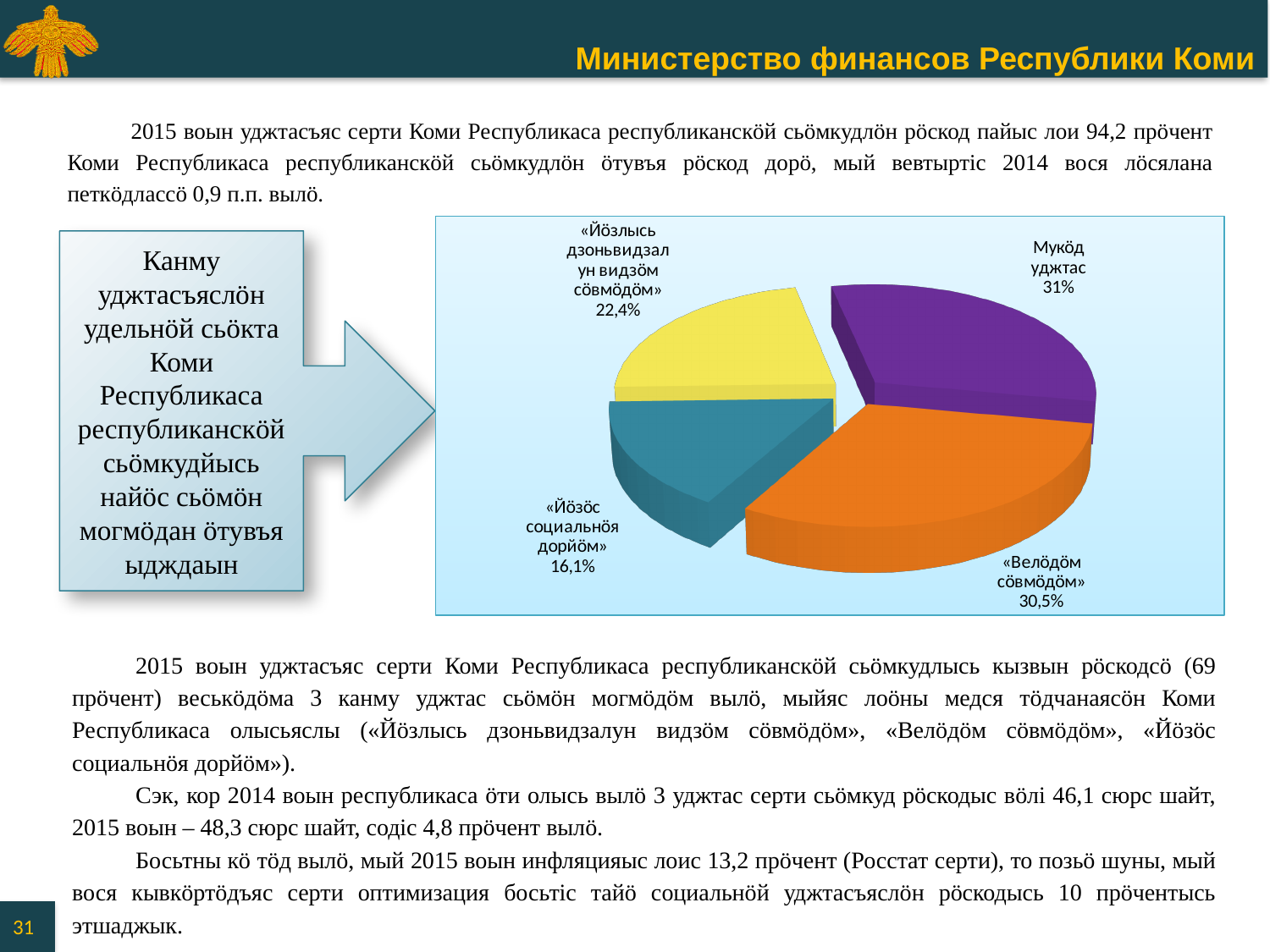
What share of the pie is labelled «Йöзöс социальнöя дорйöм»? 16,1% What is the difference in percentage points between «Велöдöм сöвмöдöм» and «Йöзöс социальнöя дорйöм»? 14,4 How many slices does the pie chart have? 4 What share of the pie is labelled «Велöдöм сöвмöдöм»? 30,5% Which slice of the pie chart is the largest? Мукöд уджтас What kind of chart is shown on the slide? pie chart What colour is the slice labelled «Велöдöм сöвмöдöм»? orange Which is larger: the share for «Йöзлысь дзоньвидзалун видзöм сöвмöдöм» or the share for «Йöзöс социальнöя дорйöм»? «Йöзлысь дзоньвидзалун видзöм сöвмöдöм» Which slice of the pie chart is the smallest? «Йöзöс социальнöя дорйöм» What colour is the slice labelled Мукöд уджтас? purple What share of the pie is labelled Мукöд уджтас? 31% What share of the pie is labelled «Йöзлысь дзоньвидзалун видзöм сöвмöдöм»? 22,4%